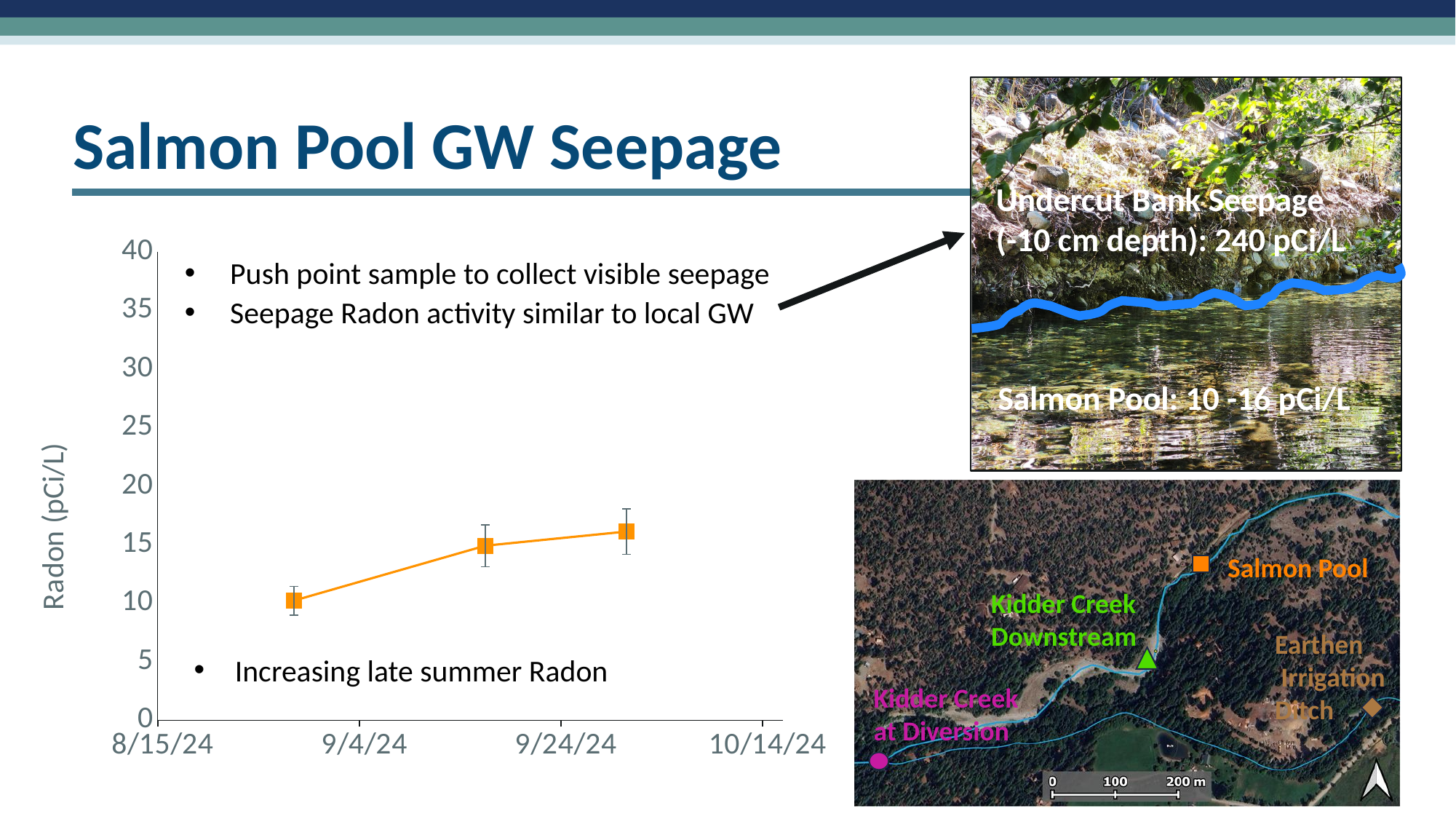
What kind of chart is shown on the left of the slide? line chart Is the Radon value for the latest (late September) point greater or less than 20? less How many date tick labels are shown on the x axis of the chart? 4 Which plotted point has the lowest Radon value? the earliest (late August) point How many data points are plotted on the Radon chart? 3 What is the label on the y axis of the chart? Radon (pCi/L) Is the Radon value for the middle (mid-September) point greater or less than 10? greater Which has the larger Radon value, the earliest point or the latest point? the latest point Is the Radon value for the earliest (late August) point greater or less than 15? less Do the Radon values rise or fall from left to right along the date axis? rise What colour are the markers and line on the Radon chart? orange